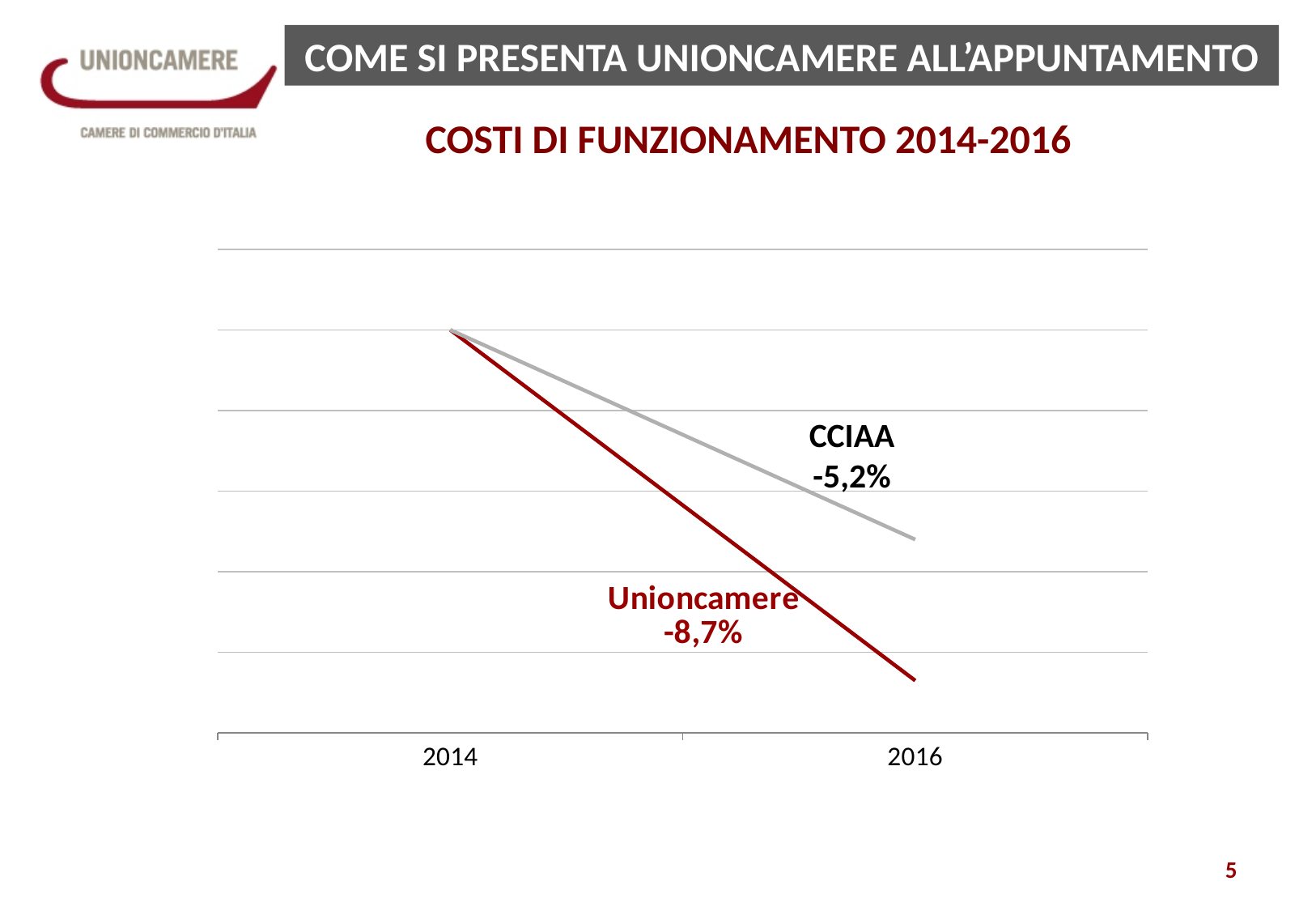
What kind of chart is shown on the slide? Line chart What percentage change is shown for CCIAA? -5,2% How many series are plotted in the chart? 2 What percentage change is shown for Unioncamere? -8,7% Which years are shown on the x axis? 2014 and 2016 How many years are shown on the x axis? 2 Which series shows the larger decline between 2014 and 2016, CCIAA or Unioncamere? Unioncamere Do the values rise or fall from 2014 to 2016? Fall What is the title of the chart? COSTI DI FUNZIONAMENTO 2014-2016 Which series shows the smaller decline between 2014 and 2016? CCIAA What colour is the Unioncamere line? Red